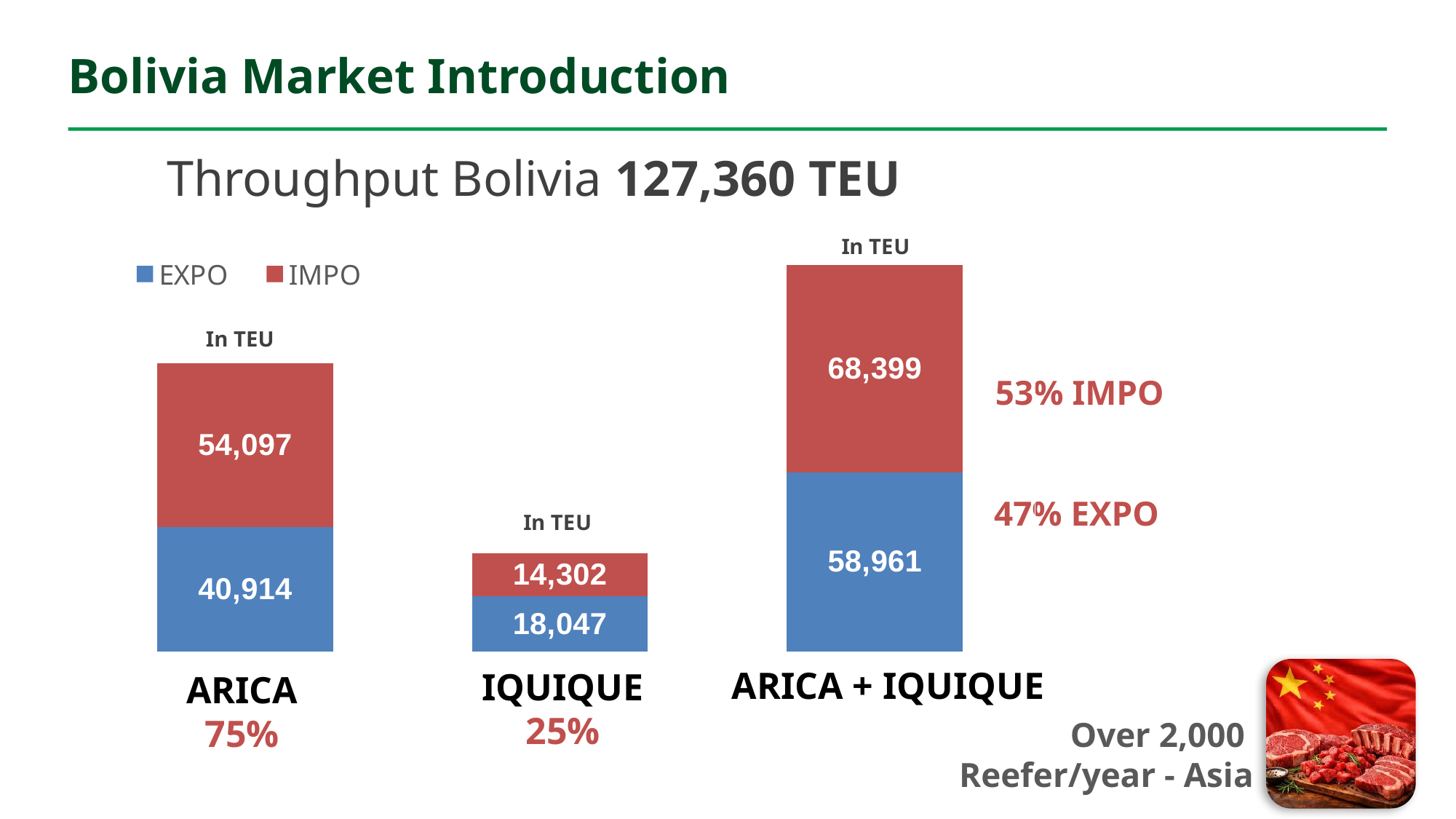
What is the EXPO value for ARICA? 40,914 What is the EXPO value for IQUIQUE? 18,047 What is the IMPO value for IQUIQUE? 14,302 Which category has the lowest IMPO value? IQUIQUE How many categories are shown on the x axis? 3 What is the total of the stacked bar for IQUIQUE? 32,349 For IQUIQUE, which is larger, EXPO or IMPO? EXPO What is the IMPO value for ARICA + IQUIQUE? 68,399 What is the difference between the IMPO and EXPO values for ARICA? 13,183 How many series does the legend list? 2 Which category has the highest EXPO value? ARICA + IQUIQUE What kind of chart is shown on the slide? Stacked bar chart